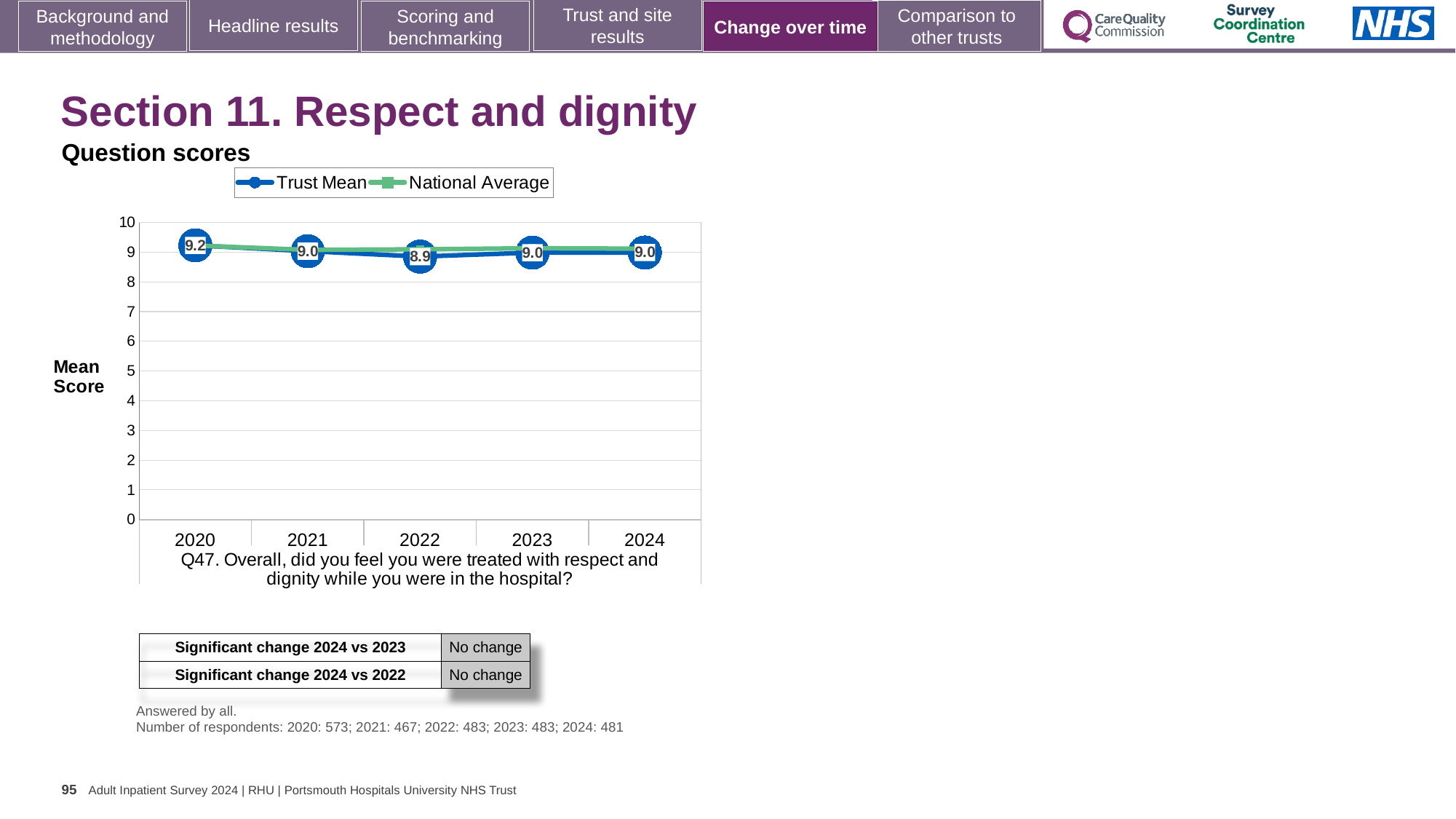
Which year has the larger Trust Mean, 2020 or 2022? 2020 What is the Trust Mean score for 2022? 8.9 How many series does the legend list? 2 What is the difference between the Trust Mean in 2020 and in 2022? 0.3 What kind of chart is shown? Line chart In which year is the Trust Mean lowest? 2022 How many years are plotted on the x axis? 5 Is the National Average value for 2023 greater or less than 8? greater What is the Trust Mean score for 2020? 9.2 In which year is the Trust Mean highest? 2020 Between 2020 and 2022, does the Trust Mean rise or fall? Fall What is the Trust Mean score for 2024? 9.0